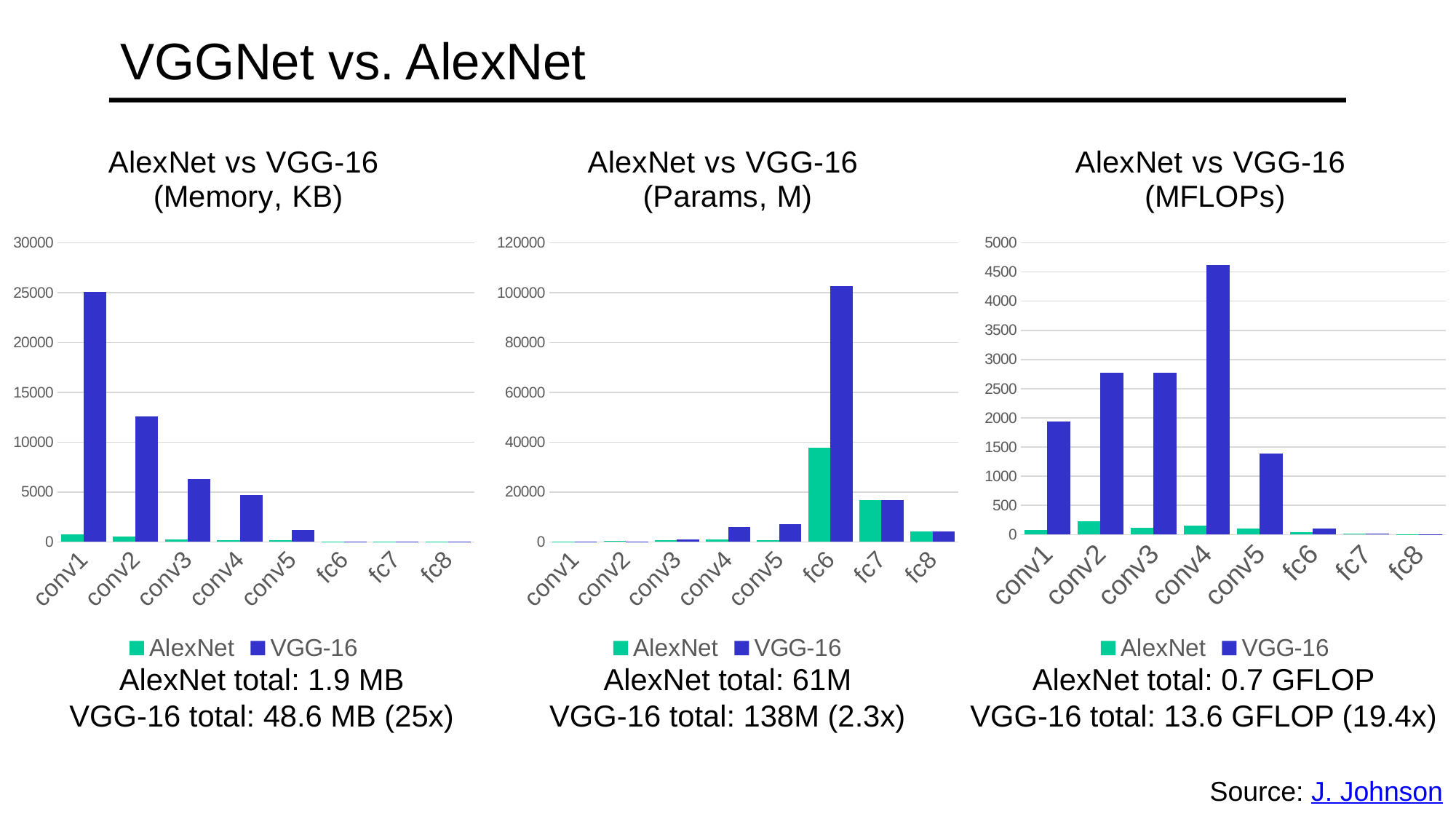
In the AlexNet vs VGG-16 (Memory, KB) chart, is the VGG-16 value for conv3 greater or less than 10000? less In the AlexNet vs VGG-16 (MFLOPs) chart, which is larger for conv2: the AlexNet value or the VGG-16 value? VGG-16 In the AlexNet vs VGG-16 (Memory, KB) chart, which layer has the highest VGG-16 value? conv1 In the AlexNet vs VGG-16 (Params, M) chart, is the VGG-16 value for fc6 greater or less than 100000? greater In the AlexNet vs VGG-16 (Memory, KB) chart, is the VGG-16 value for conv1 greater or less than 20000? greater How many series does the legend of the AlexNet vs VGG-16 (Memory, KB) chart list? 2 In the AlexNet vs VGG-16 (MFLOPs) chart, which layer has the highest VGG-16 value? conv4 In the AlexNet vs VGG-16 (Params, M) chart, which is larger for fc6: the AlexNet value or the VGG-16 value? VGG-16 How many layer categories are shown on the x axis of the AlexNet vs VGG-16 (MFLOPs) chart? 8 In the AlexNet vs VGG-16 (Params, M) chart, which layer has the highest VGG-16 value? fc6 In the AlexNet vs VGG-16 (Memory, KB) chart, do the VGG-16 values rise or fall from conv1 to conv5? fall